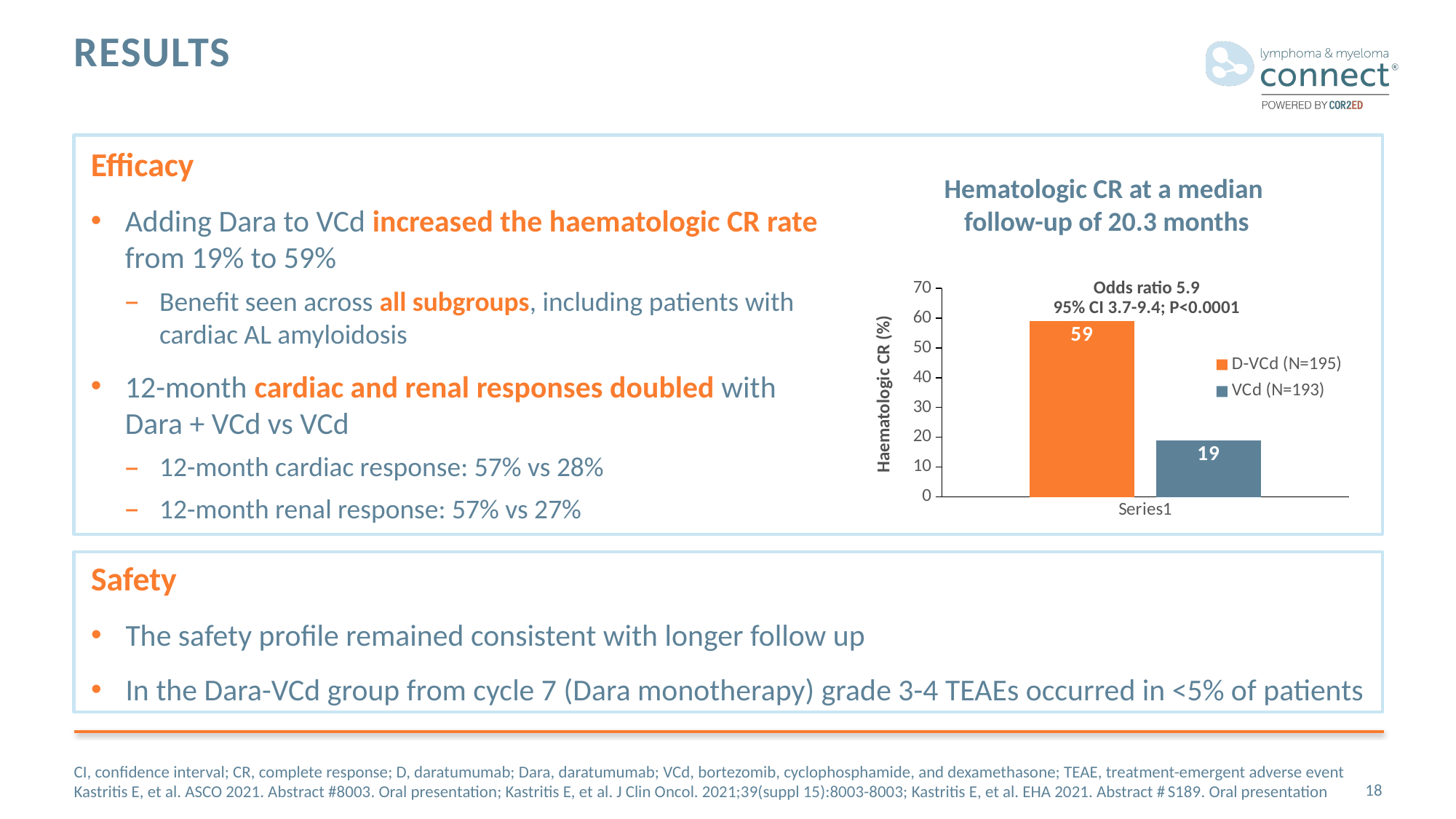
Which series has the higher hematologic CR? D-VCd (N=195) What is the title of the chart? Hematologic CR at a median follow-up of 20.3 months What is the hematologic CR value for D-VCd (N=195)? 59 What is the difference in hematologic CR between D-VCd (N=195) and VCd (N=193)? 40 What kind of chart is shown on the slide? Bar chart What is the maximum value shown on the y axis of the chart? 70 What is the label of the y axis of the chart? Haematologic CR (%) Which series has the lower hematologic CR? VCd (N=193) Is the hematologic CR for D-VCd (N=195) greater or less than 50? greater Is the hematologic CR for VCd (N=193) greater or less than 20? less What is the hematologic CR value for VCd (N=193)? 19 How many series does the legend list? 2